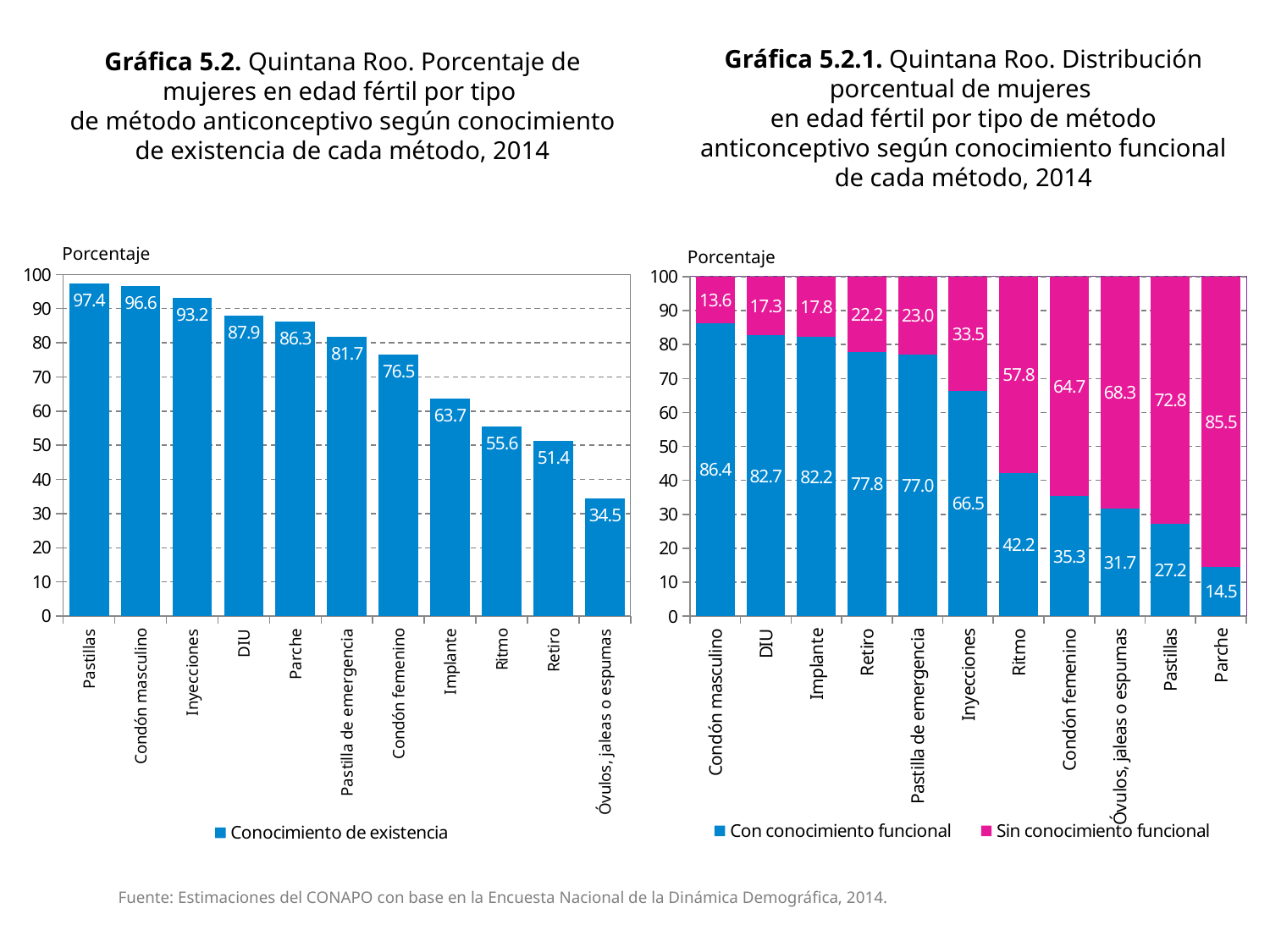
In Gráfica 5.2.1 (right chart), what is the total of the stacked bar for DIU? 100.0 In Gráfica 5.2 (left chart), what is the difference between the values for Condón masculino and Retiro? 45.2 In Gráfica 5.2.1 (right chart), what is the value of Con conocimiento funcional for Inyecciones? 66.5 In Gráfica 5.2 (left chart), which category has the lowest value? Óvulos, jaleas o espumas In Gráfica 5.2 (left chart), how many categories are shown on the x axis? 11 In Gráfica 5.2.1 (right chart), what is the value of Sin conocimiento funcional for Parche? 85.5 What kind of chart is Gráfica 5.2.1 (right chart)? stacked bar chart In Gráfica 5.2.1 (right chart), which category has the highest value of Con conocimiento funcional? Condón masculino In Gráfica 5.2.1 (right chart), which is larger for Ritmo: Con conocimiento funcional or Sin conocimiento funcional? Sin conocimiento funcional In Gráfica 5.2.1 (right chart), how many series does the legend list? 2 In Gráfica 5.2 (left chart), do the values rise or fall from left to right along the x axis? fall In Gráfica 5.2 (left chart), what is the value for Pastillas? 97.4